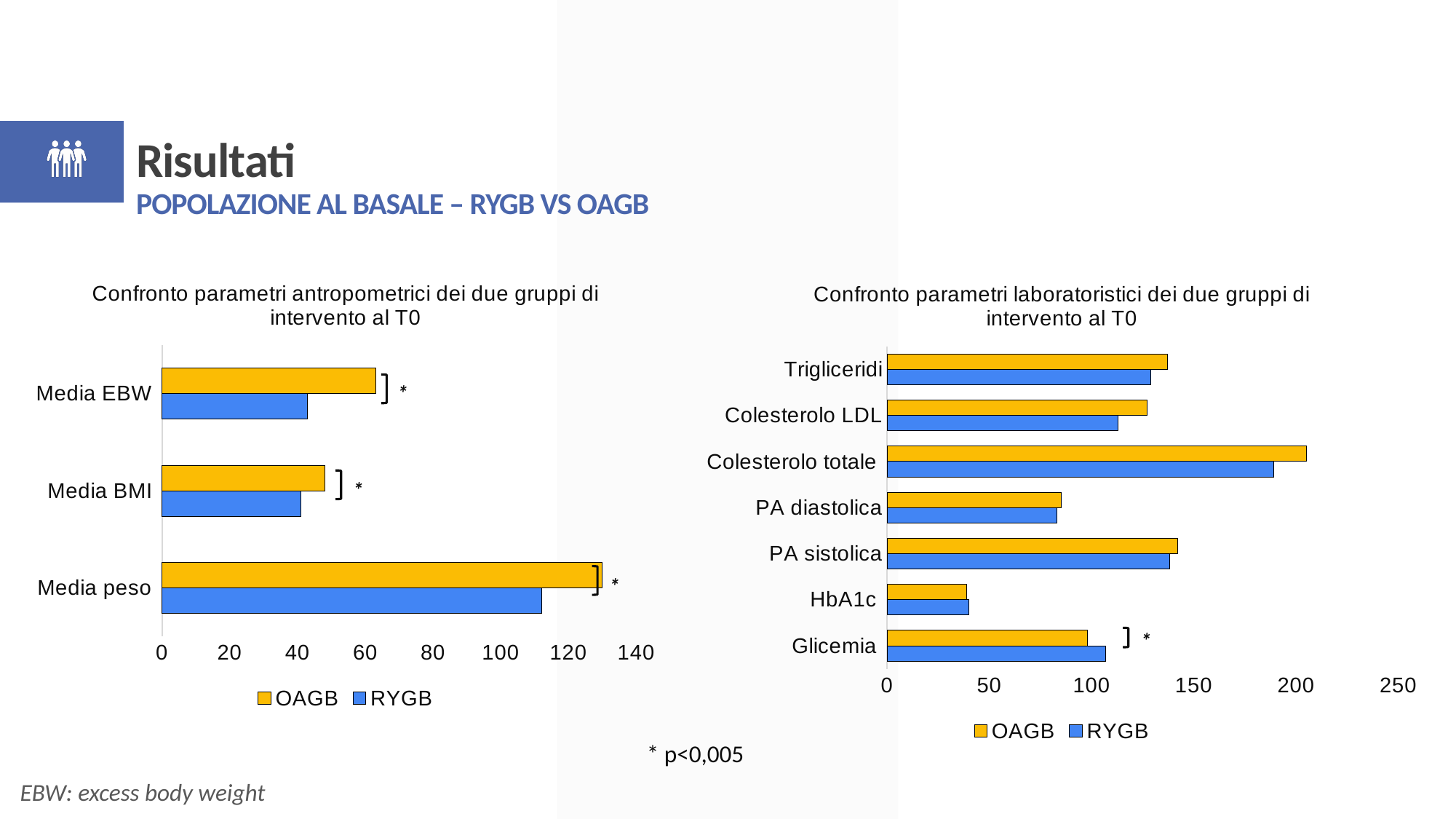
On the right chart (parametri laboratoristici), which category has the lowest value for RYGB? HbA1c How many categories are shown on the left chart (parametri antropometrici)? 3 How many categories are shown on the right chart (parametri laboratoristici)? 7 On the left chart (parametri antropometrici), is the OAGB value for Media peso greater or less than 120? greater On the left chart (parametri antropometrici), which category has the highest value for OAGB? Media peso On the left chart (parametri antropometrici), which category has the lowest value for RYGB? Media BMI On the right chart (parametri laboratoristici), which category has the highest value for OAGB? Colesterolo totale What kind of chart is the left chart titled 'Confronto parametri antropometrici dei due gruppi di intervento al T0'? bar chart On the right chart (parametri laboratoristici), which is larger for Colesterolo LDL, OAGB or RYGB? OAGB How many series does the legend of the right chart (parametri laboratoristici) list? 2 On the left chart (parametri antropometrici), is the RYGB value for Media EBW greater or less than 60? less On the right chart (parametri laboratoristici), is the OAGB value for Colesterolo totale greater or less than 200? greater